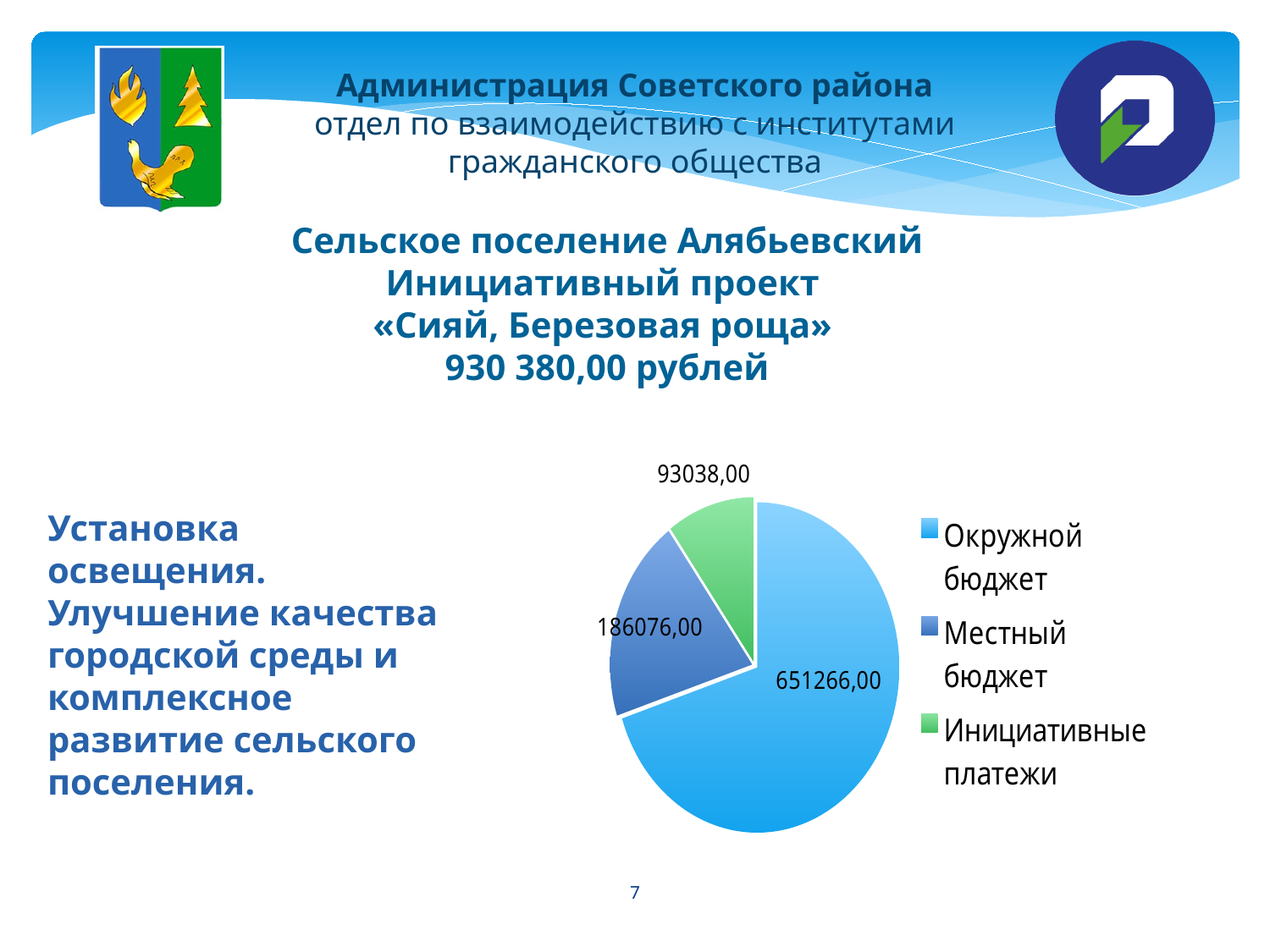
Which is larger in the pie chart: Местный бюджет or Инициативные платежи? Местный бюджет What is the value for Местный бюджет in the pie chart? 186076,00 What share of the pie does Окружной бюджет represent? 70% How many entries does the legend of the pie chart list? 3 What colour is the slice for Инициативные платежи in the pie chart? green What is the value for Инициативные платежи in the pie chart? 93038,00 What is the value for Окружной бюджет in the pie chart? 651266,00 Which category has the smallest slice in the pie chart? Инициативные платежи Which category has the largest slice in the pie chart? Окружной бюджет How many slices does the pie chart have? 3 What kind of chart is shown on the slide? pie chart What is the difference between the values for Окружной бюджет and Местный бюджет? 465190,00